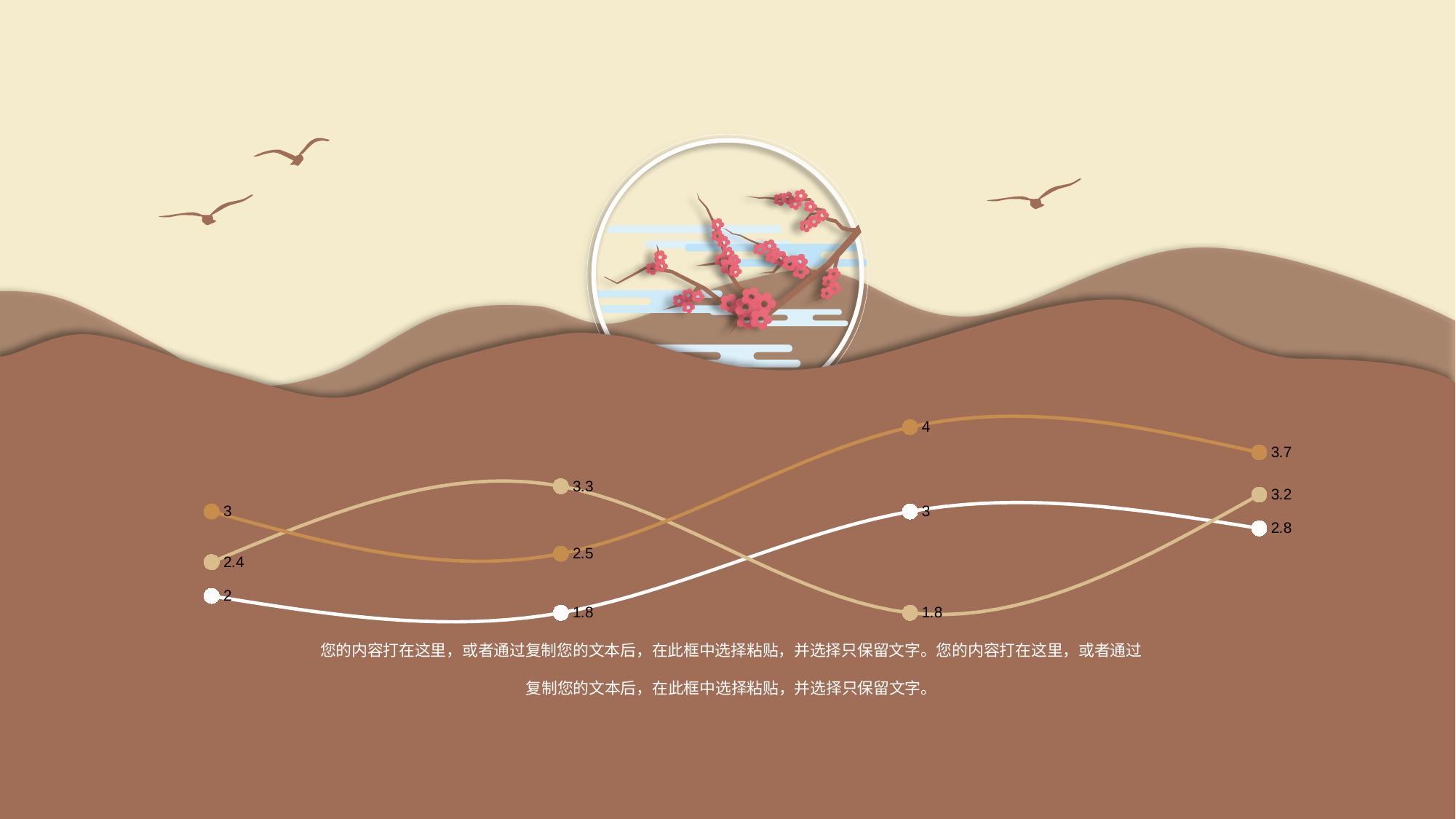
What is the value of the third point on the orange line? 4 What is the highest value labelled on the orange line? 4 What is the difference between the second and third points on the tan (light brown) line (3.3 and 1.8)? 1.5 What kind of chart is shown on the slide? line chart What is the value of the last point on the tan (light brown) line? 3.2 Does the white line rise or fall from its second point to its third point? rise What is the difference between the first and second points on the orange line (3 and 2.5)? 0.5 What is the value of the second point on the white line? 1.8 How many lines are plotted on the chart? 3 What is the lowest value labelled on the white line? 1.8 At the last point, which line has the larger value: the orange line or the white line? the orange line How many data points does each line on the chart have? 4